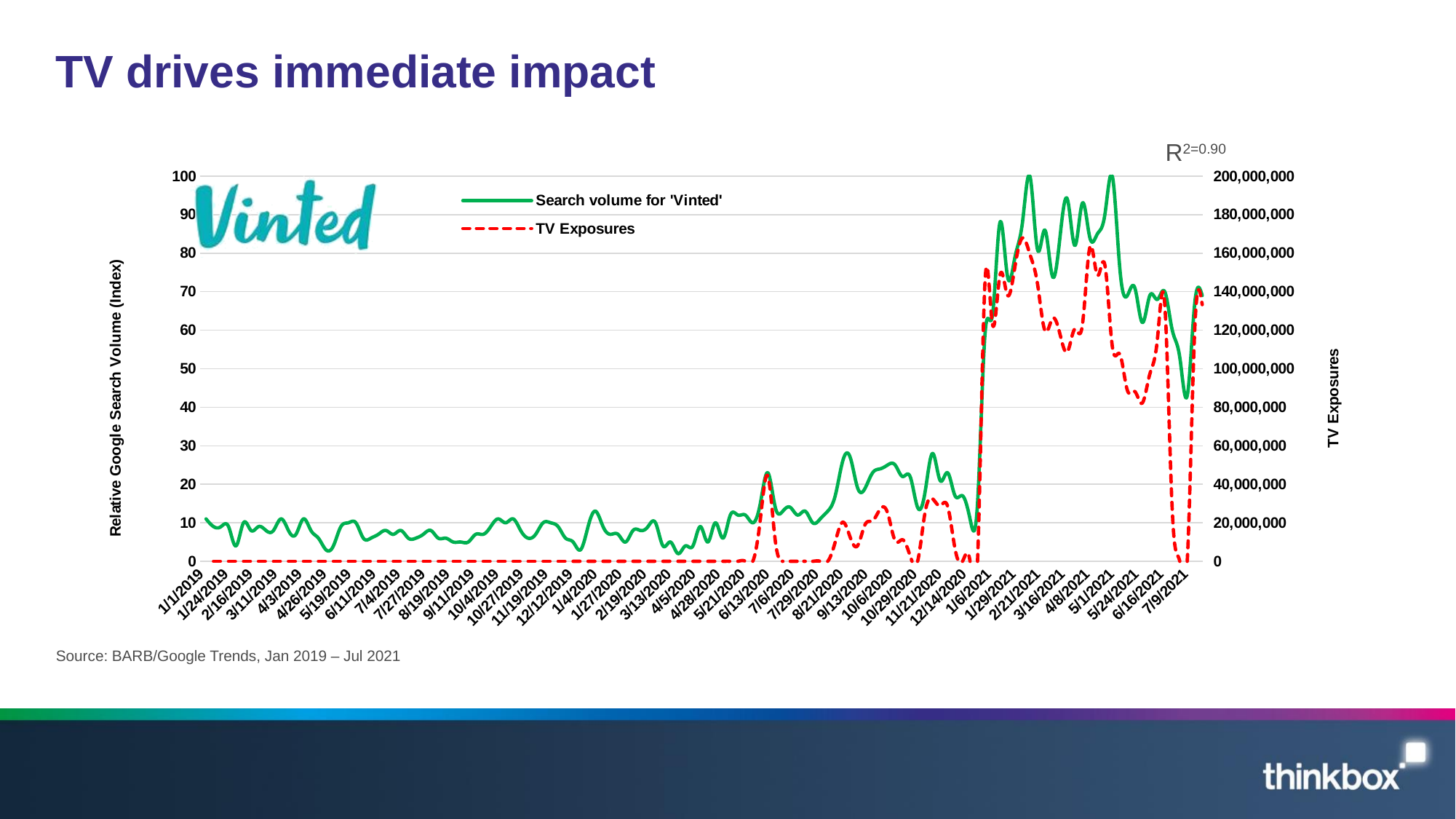
What is the title of the slide containing the chart? TV drives immediate impact What kind of chart is shown on the slide? Line chart Is the value of 'Search volume for Vinted' at its highest peak in early 2021 greater or less than 90 on the left axis? greater Is the value of 'Search volume for Vinted' on 3/16/2021 greater or less than 50? greater How many series does the chart's legend list? 2 What R-squared value is annotated on the chart? 0.90 Which series is drawn as a red dashed line? TV Exposures Is the value of 'Search volume for Vinted' on 7/4/2019 greater or less than 20? less Does 'Search volume for Vinted' generally rise or fall from January 2019 to July 2021? rise